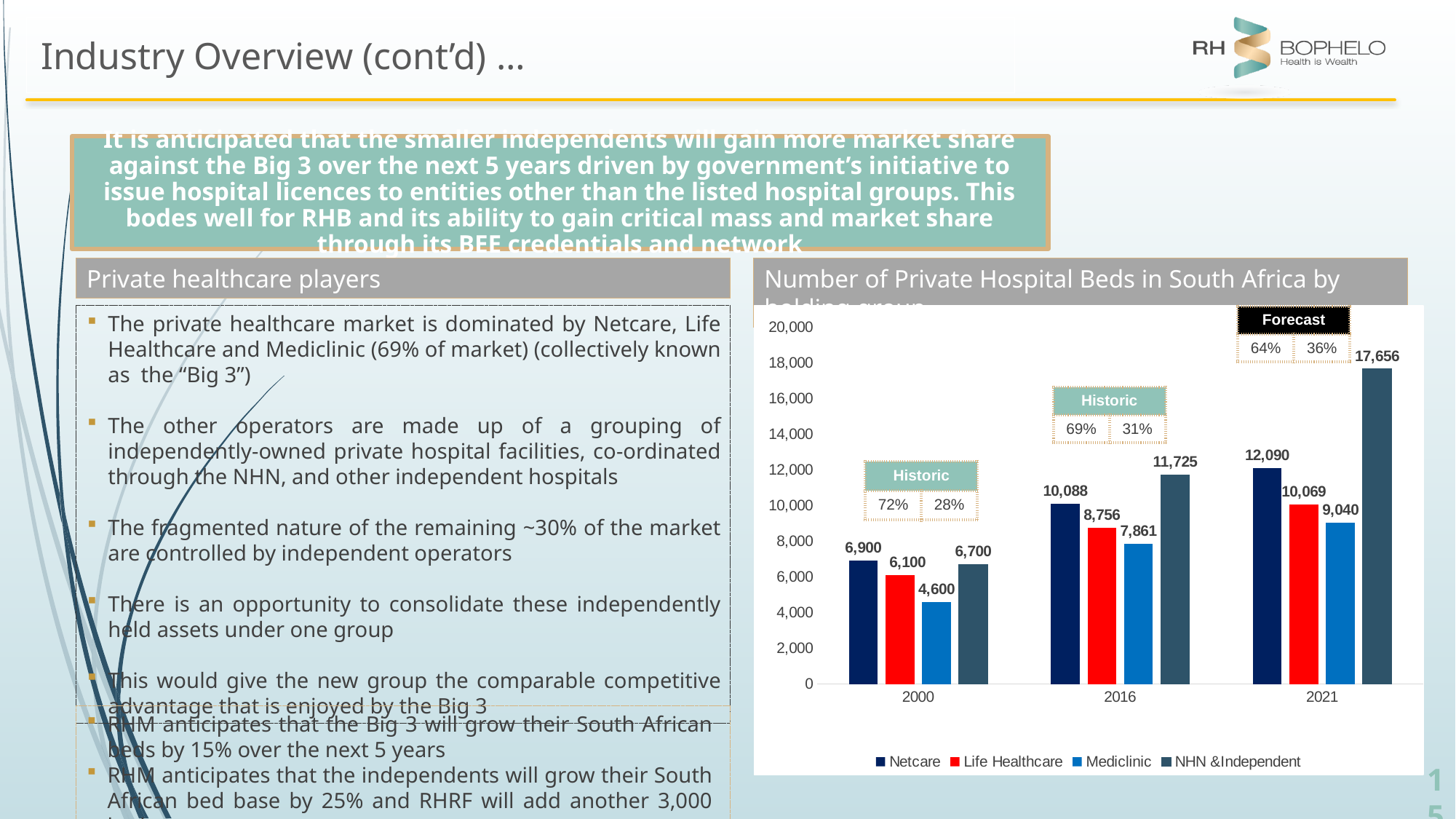
What is the value for NHN & Independent in 2021? 17,656 How many series does the legend list? 4 Which series has the lowest value in 2000? Mediclinic Do the Mediclinic values rise or fall from 2000 to 2021? Rise What is the value for Netcare in 2000? 6,900 Which series has the highest value in 2021? NHN & Independent How many year categories are shown on the x axis? 3 What is the difference between the Netcare and Life Healthcare values in 2016? 1,332 What is the value for Mediclinic in 2016? 7,861 What is the value for Life Healthcare in 2021? 10,069 What kind of chart is shown? Bar chart Which is larger in 2000: Netcare or NHN & Independent? Netcare